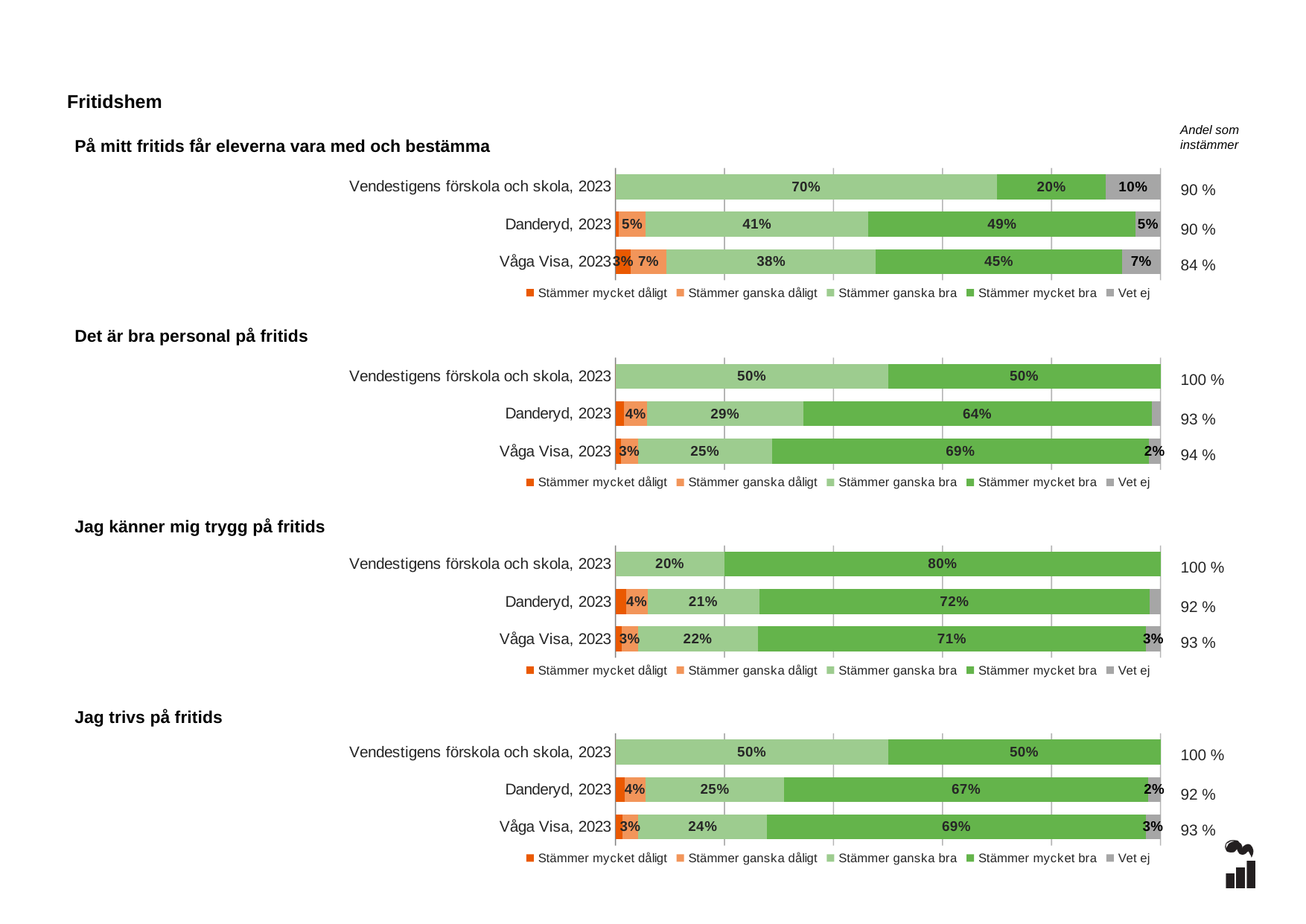
In the chart 'Jag känner mig trygg på fritids', which category has the highest 'Stämmer mycket bra' value? Vendestigens förskola och skola, 2023 In the chart 'Det är bra personal på fritids', what is the 'Stämmer mycket bra' value for Våga Visa, 2023? 69% How many categories are shown in the chart 'Det är bra personal på fritids'? 3 In the chart 'På mitt fritids får eleverna vara med och bestämma', what is the 'Stämmer ganska bra' value for Vendestigens förskola och skola, 2023? 70% How many series does the legend list in the chart 'Jag trivs på fritids'? 5 What kind of chart is 'Jag känner mig trygg på fritids'? Stacked bar chart In the chart 'På mitt fritids får eleverna vara med och bestämma', what is the 'Stämmer mycket bra' value for Danderyd, 2023? 49% In the chart 'Det är bra personal på fritids', what is the difference between the 'Stämmer mycket bra' values for Danderyd, 2023 and Vendestigens förskola och skola, 2023? 14% In the chart 'Jag trivs på fritids', is the 'Stämmer mycket bra' value for Våga Visa, 2023 larger or smaller than that for Danderyd, 2023? larger In the chart 'På mitt fritids får eleverna vara med och bestämma', which category has the lowest 'Andel som instämmer'? Våga Visa, 2023 In the chart 'Jag trivs på fritids', what is the 'Stämmer ganska bra' value for Danderyd, 2023? 25% In the chart 'Jag känner mig trygg på fritids', what is the 'Stämmer mycket bra' value for Vendestigens förskola och skola, 2023? 80%